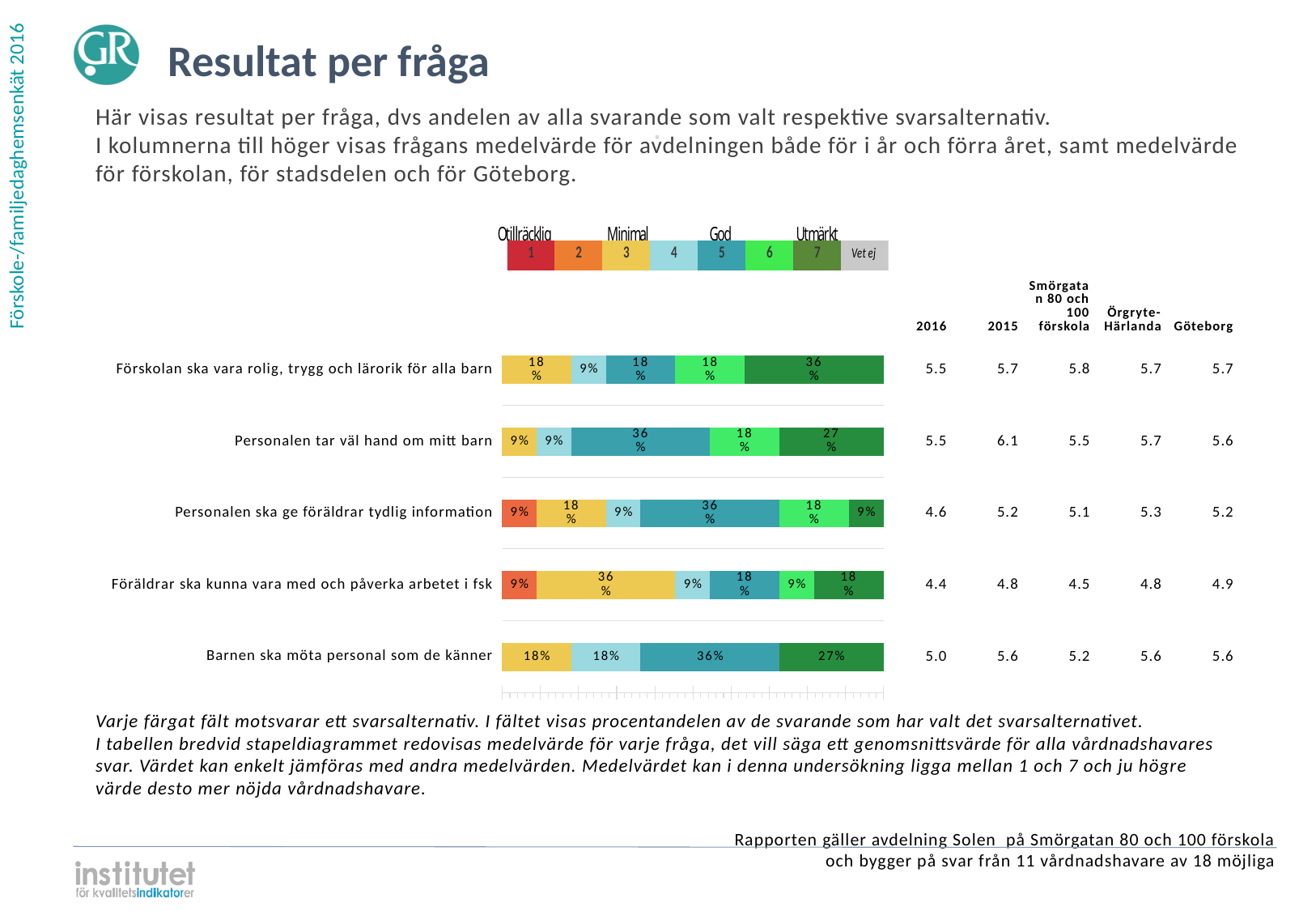
What kind of chart is used to show the share of respondents choosing each answer alternative? Stacked bar chart How many questions (bars) are shown in the chart? 5 What percentage of respondents chose answer 3 (yellow) for 'Föräldrar ska kunna vara med och påverka arbetet i fsk'? 36% For 'Barnen ska möta personal som de känner', which answer alternative has the largest share of respondents? 5 What is the 2016 mean value shown for 'Föräldrar ska kunna vara med och påverka arbetet i fsk'? 4.4 What colour represents answer alternative 1 (Otillräcklig) in the legend? Red For 'Personalen ska ge föräldrar tydlig information', what is the difference between the share choosing answer 5 and the share choosing answer 7? 27% What percentage of respondents chose answer 7 (Utmärkt, dark green) for 'Förskolan ska vara rolig, trygg och lärorik för alla barn'? 36% Which question has the lowest 2016 mean value in the table next to the chart? Föräldrar ska kunna vara med och påverka arbetet i fsk What percentage of respondents chose answer 5 (teal) for 'Personalen tar väl hand om mitt barn'? 36% How many answer alternatives does the legend above the chart list? 8 For 'Personalen tar väl hand om mitt barn', which is larger: the share choosing answer 6 or the share choosing answer 7? Answer 7